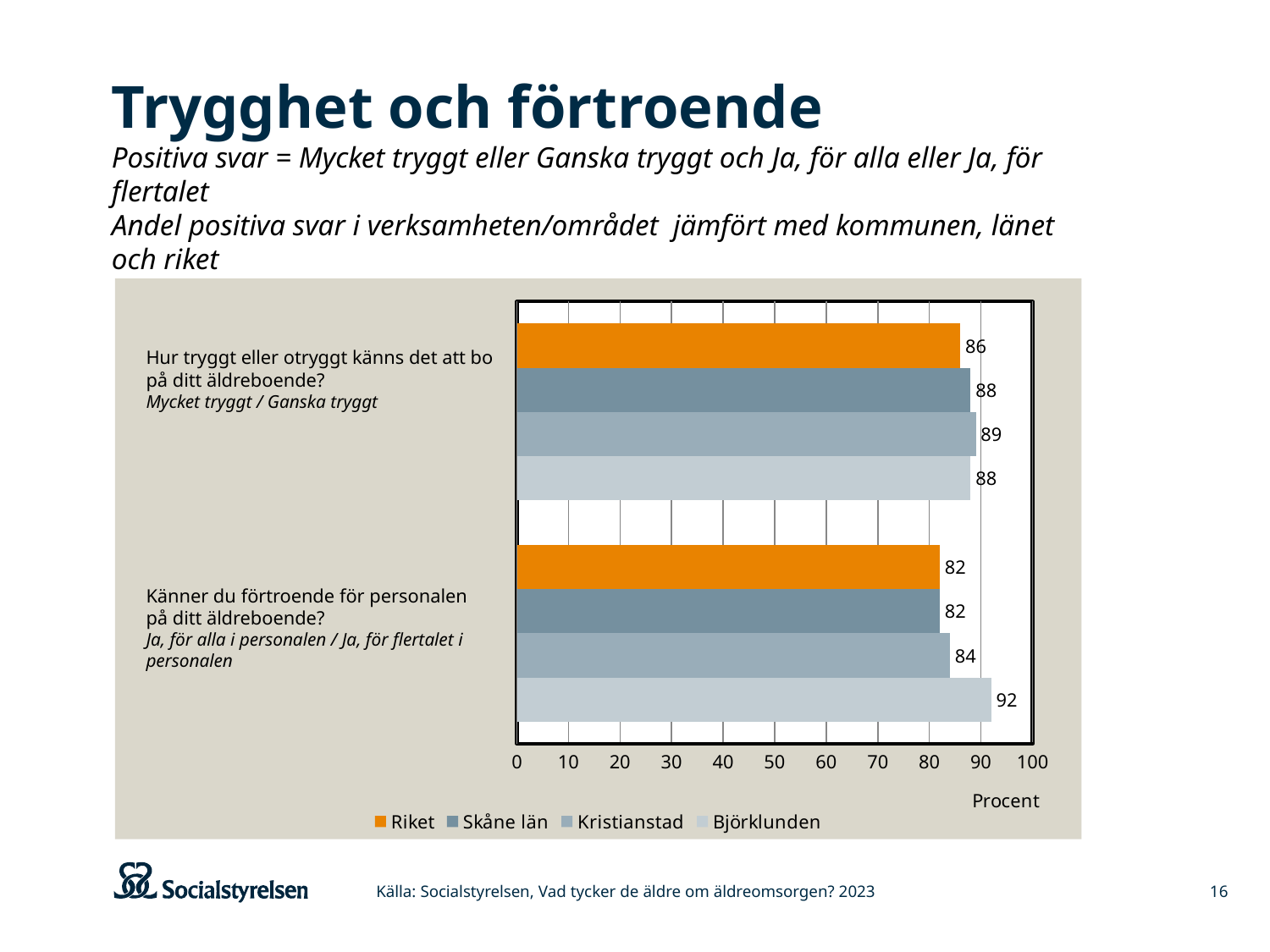
Which series has the highest value on the question "Känner du förtroende för personalen på ditt äldreboende?"? Björklunden What is the difference between Kristianstad and Riket on the question "Hur tryggt eller otryggt känns det att bo på ditt äldreboende?"? 3 What is the value for Kristianstad on the question "Hur tryggt eller otryggt känns det att bo på ditt äldreboende?"? 89 What is the value for Skåne län on the question "Känner du förtroende för personalen på ditt äldreboende?"? 82 What is the value for Riket on the question "Hur tryggt eller otryggt känns det att bo på ditt äldreboende?"? 86 How many series does the legend list? 4 What is the value for Björklunden on the question "Känner du förtroende för personalen på ditt äldreboende?"? 92 What is the difference between Björklunden and Riket on the question "Känner du förtroende för personalen på ditt äldreboende?"? 10 Which series has the lowest value on the question "Hur tryggt eller otryggt känns det att bo på ditt äldreboende?"? Riket What kind of chart is shown on the slide? Bar chart What is the label of the horizontal axis? Procent On the question "Känner du förtroende för personalen på ditt äldreboende?", which is larger: Björklunden or Kristianstad? Björklunden